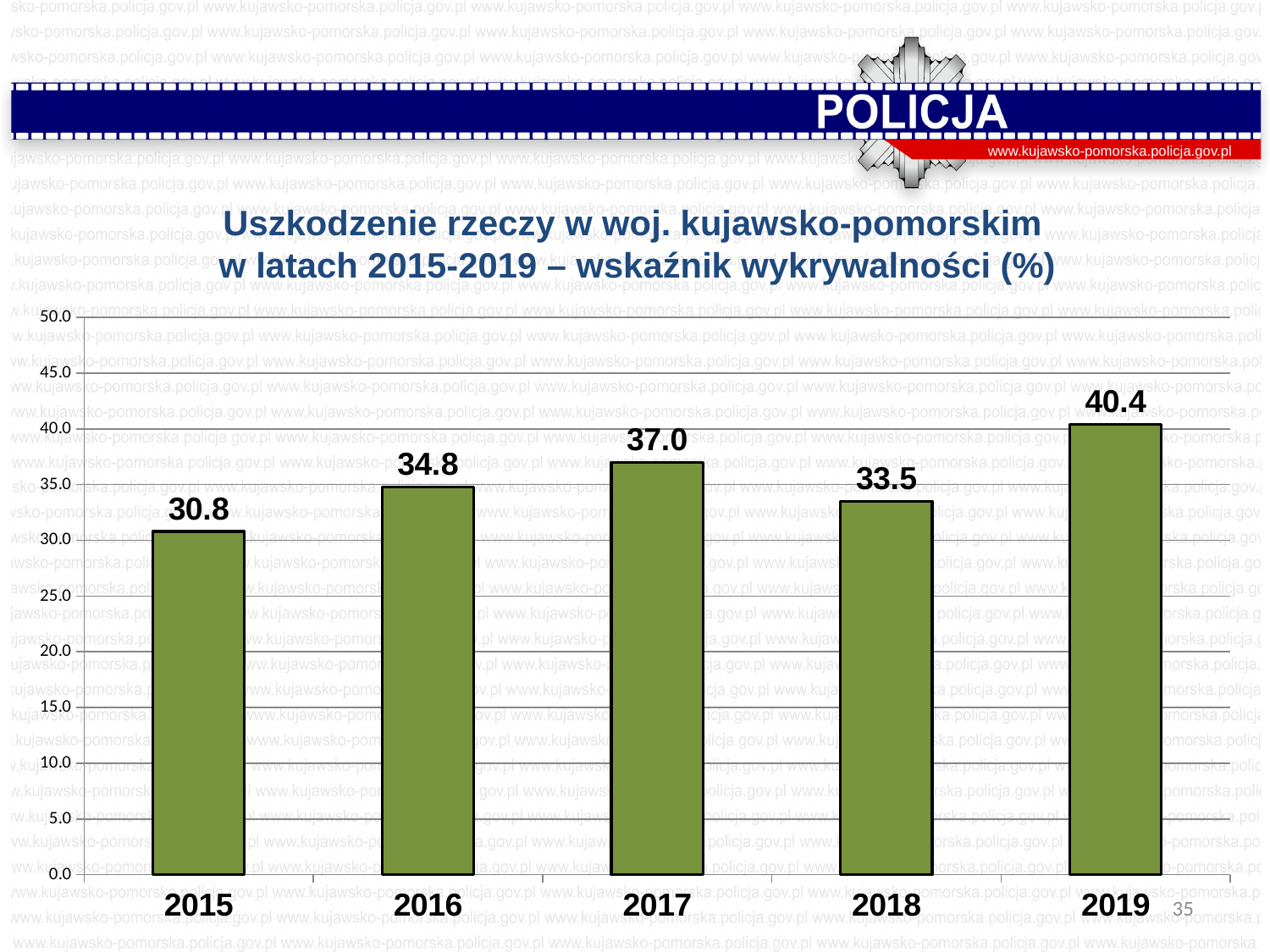
What is the detection rate for 2017? 37.0 How many years are shown on the chart? 5 What is the difference between the values for 2019 and 2015? 9.6 Which is larger, the value for 2016 or the value for 2018? 2016 Is the value for 2019 greater or less than 40.0? greater What kind of chart is shown on the slide? bar chart What is the title of the chart? Uszkodzenie rzeczy w woj. kujawsko-pomorskim w latach 2015-2019 – wskaźnik wykrywalności (%) Which year has the lowest detection rate? 2015 What is the value shown for 2018? 33.5 Which year has the highest detection rate? 2019 What is the value shown for 2015? 30.8 What is the difference between the values for 2017 and 2018? 3.5